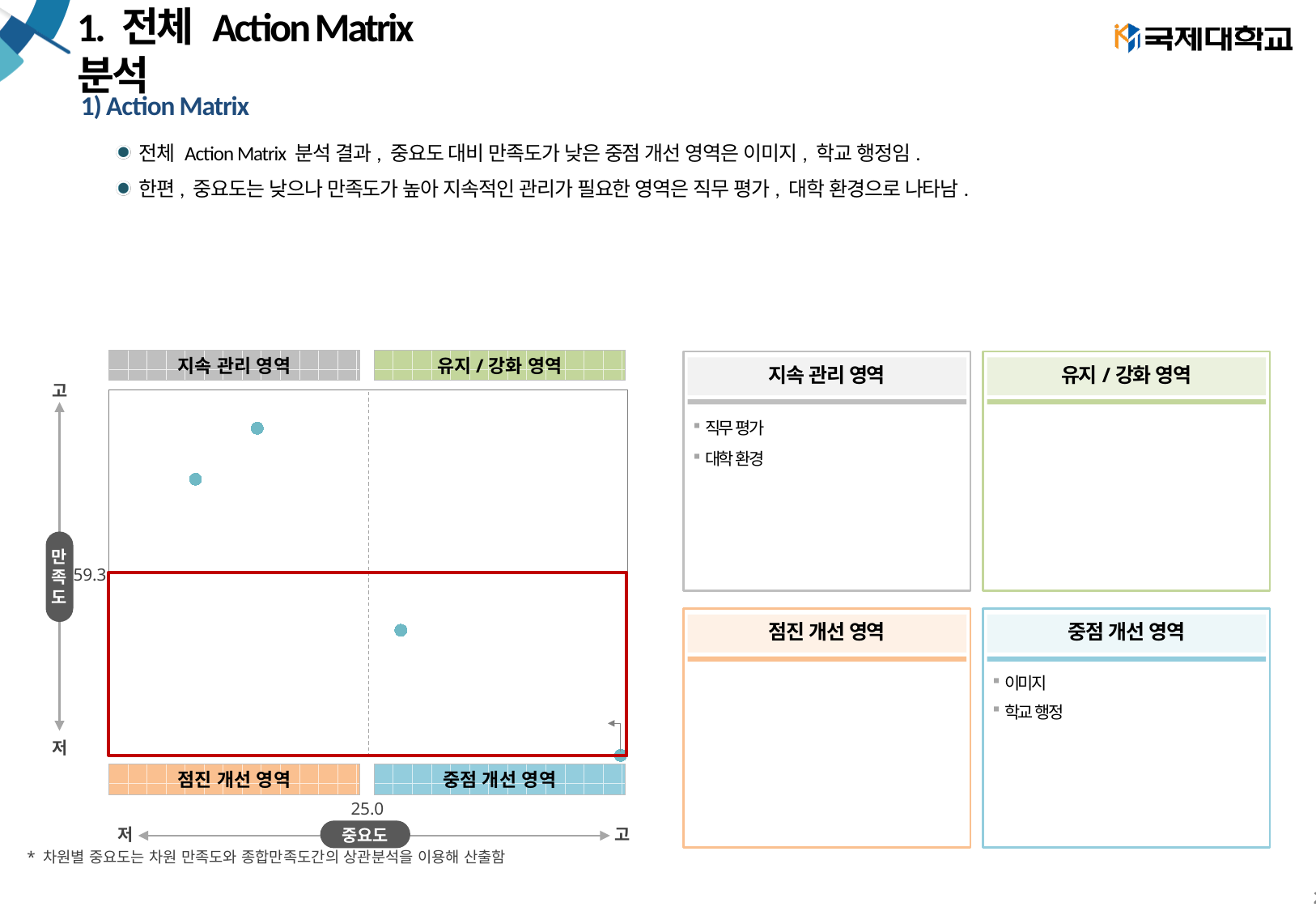
How many data points are plotted in the Action Matrix chart? 4 How many points in the Action Matrix chart fall in the 유지 / 강화 영역 quadrant (upper right)? 0 How many points in the Action Matrix chart fall in the 지속 관리 영역 quadrant (upper left)? 2 In the Action Matrix chart, what value is marked on the 만족도 (y) axis where the horizontal dividing line is drawn? 59.3 In the Action Matrix chart, what value is marked on the 중요도 (x) axis where the vertical dividing line is drawn? 25.0 Which quadrant of the Action Matrix chart is outlined with a red box? Both lower quadrants: 점진 개선 영역 and 중점 개선 영역 What kind of chart is the Action Matrix on the left of the slide? scatter chart What is the label of the vertical axis of the Action Matrix chart? 만족도